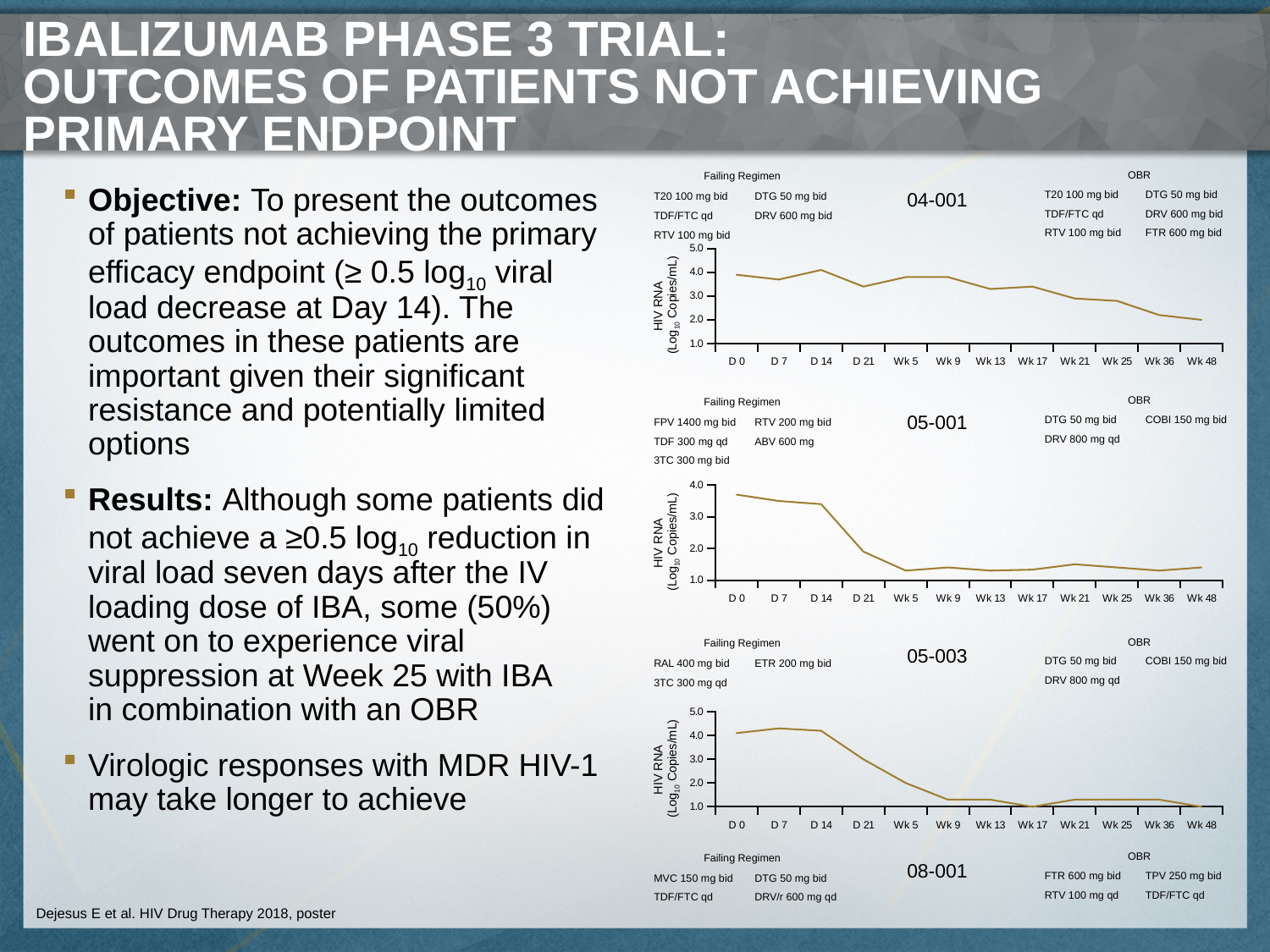
In the 05-001 chart, is the value at Wk 5 greater or less than 2.0? less In the 04-001 chart, how many time points are shown on the x axis? 12 In the 05-003 chart, is the value at Wk 9 greater or less than 2.0? less What kind of chart is used for patient 04-001? line chart In the 05-001 chart, is the value at D 14 greater or less than 3.0? greater In the 05-001 chart, which time point has the highest HIV RNA value? D 0 What is the y-axis label on the 05-003 chart? HIV RNA (Log10 Copies/mL) In the 04-001 chart, which is larger, the value at D 0 or the value at Wk 36? D 0 In the 04-001 chart, do the HIV RNA values rise or fall overall from D 0 to Wk 48? fall